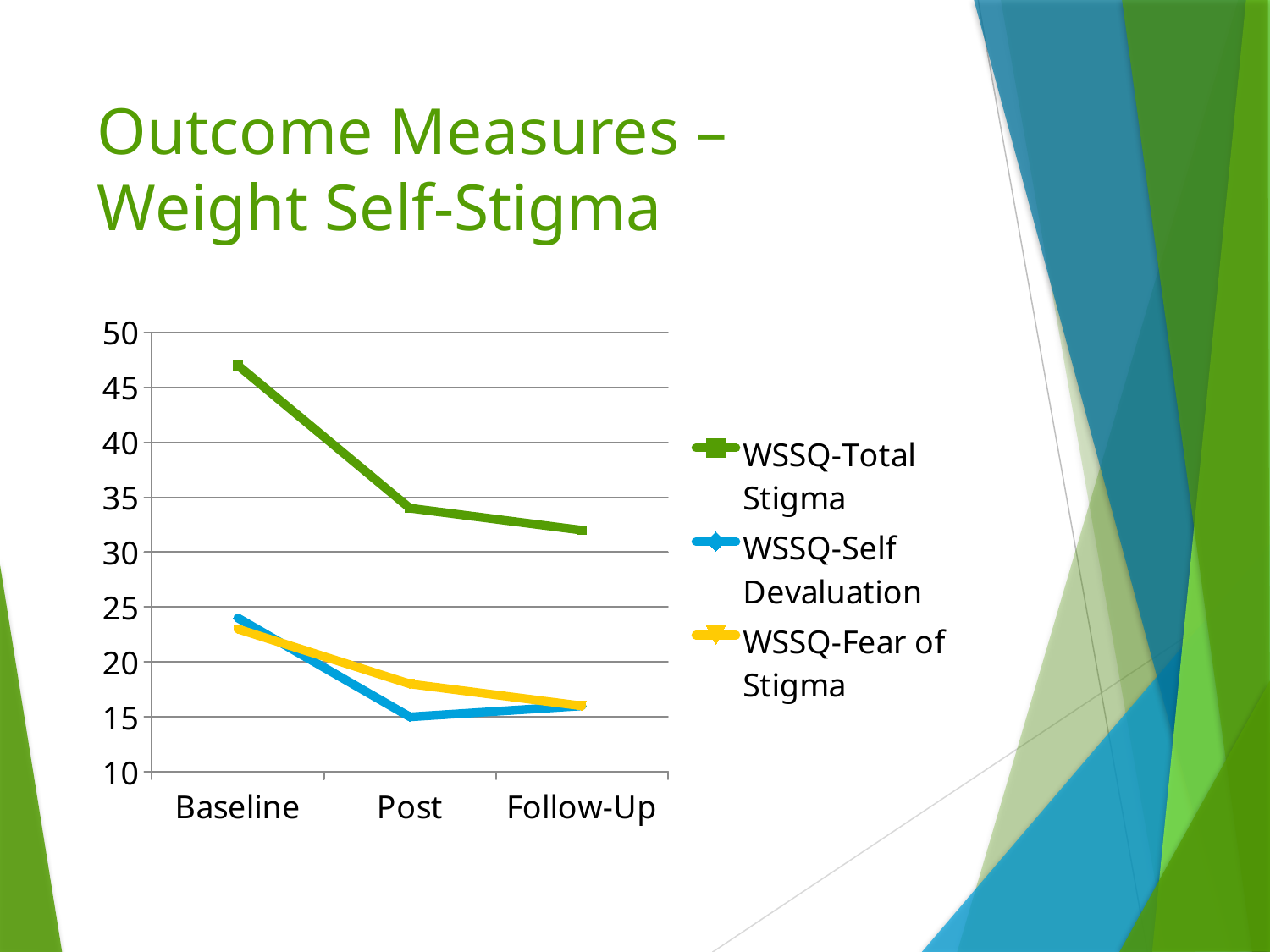
At Post, which is larger: WSSQ-Self Devaluation or WSSQ-Fear of Stigma? WSSQ-Fear of Stigma Is the WSSQ-Self Devaluation value at Baseline greater or less than 20? greater Does the WSSQ-Total Stigma line rise or fall from Baseline to Follow-Up? fall At which time point is WSSQ-Total Stigma lowest? Follow-Up What colour is the WSSQ-Total Stigma line? green How many series does the legend list? 3 Is the WSSQ-Total Stigma value at Baseline greater or less than 45? greater Is the WSSQ-Total Stigma value at Post greater or less than 40? less How many time points are shown on the x axis? 3 At which time point is WSSQ-Total Stigma highest? Baseline What kind of chart is shown on the slide? line chart